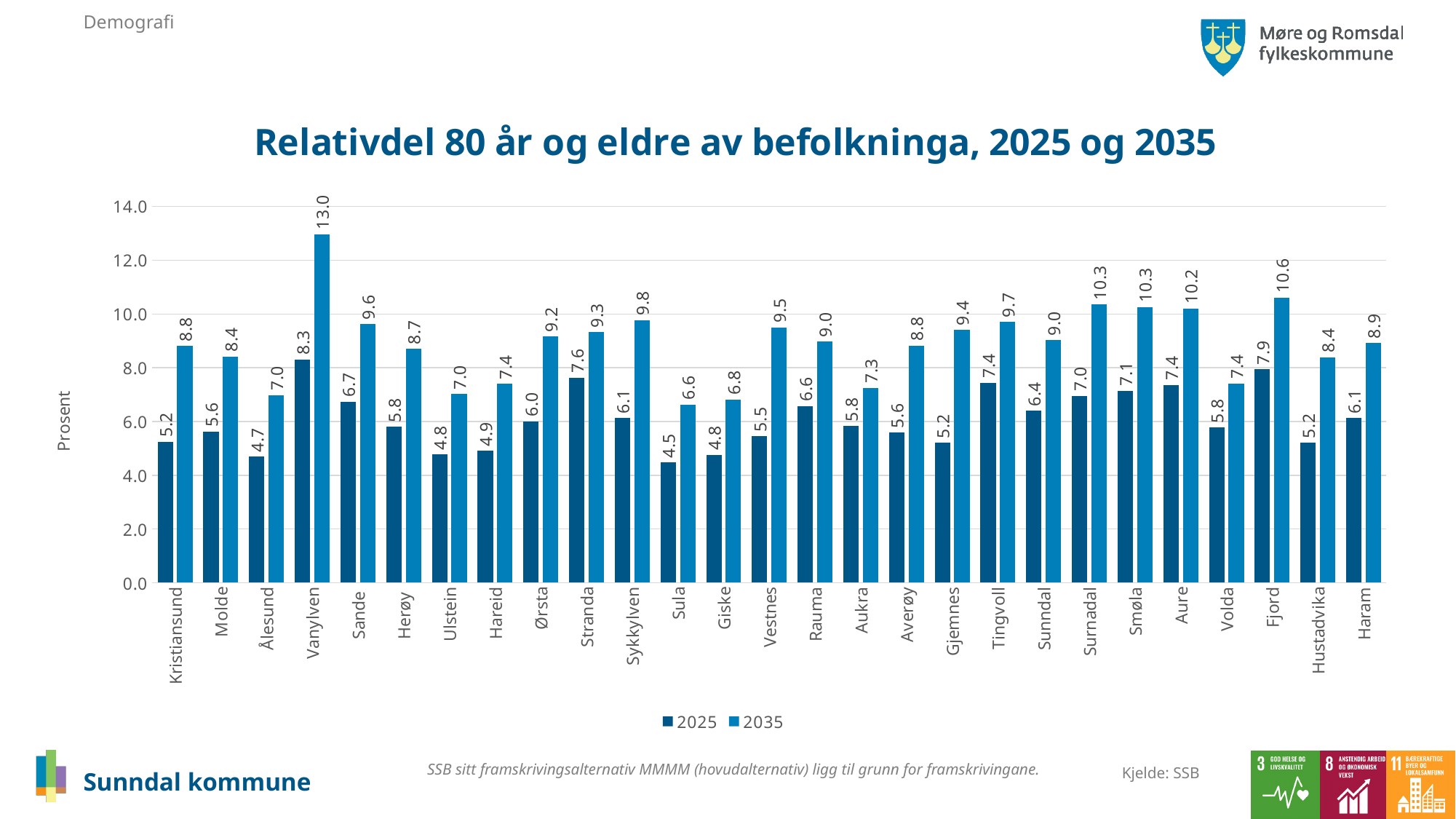
What is the 2035 value for Vanylven? 13.0 Which is larger, the 2025 value for Stranda or the 2025 value for Tingvoll? Stranda How many municipalities are shown on the x axis? 27 How many series does the legend list? 2 Which municipality has the highest 2035 value? Vanylven What is the label on the y axis? Prosent What is the difference between the 2035 and 2025 values for Gjemnes? 4.2 What is the 2035 value for Fjord? 10.6 What is the 2025 value for Sunndal? 6.4 Is the 2035 value for Surnadal greater or less than 10.0? greater What kind of chart is shown? bar chart Which municipality has the lowest 2025 value? Sula